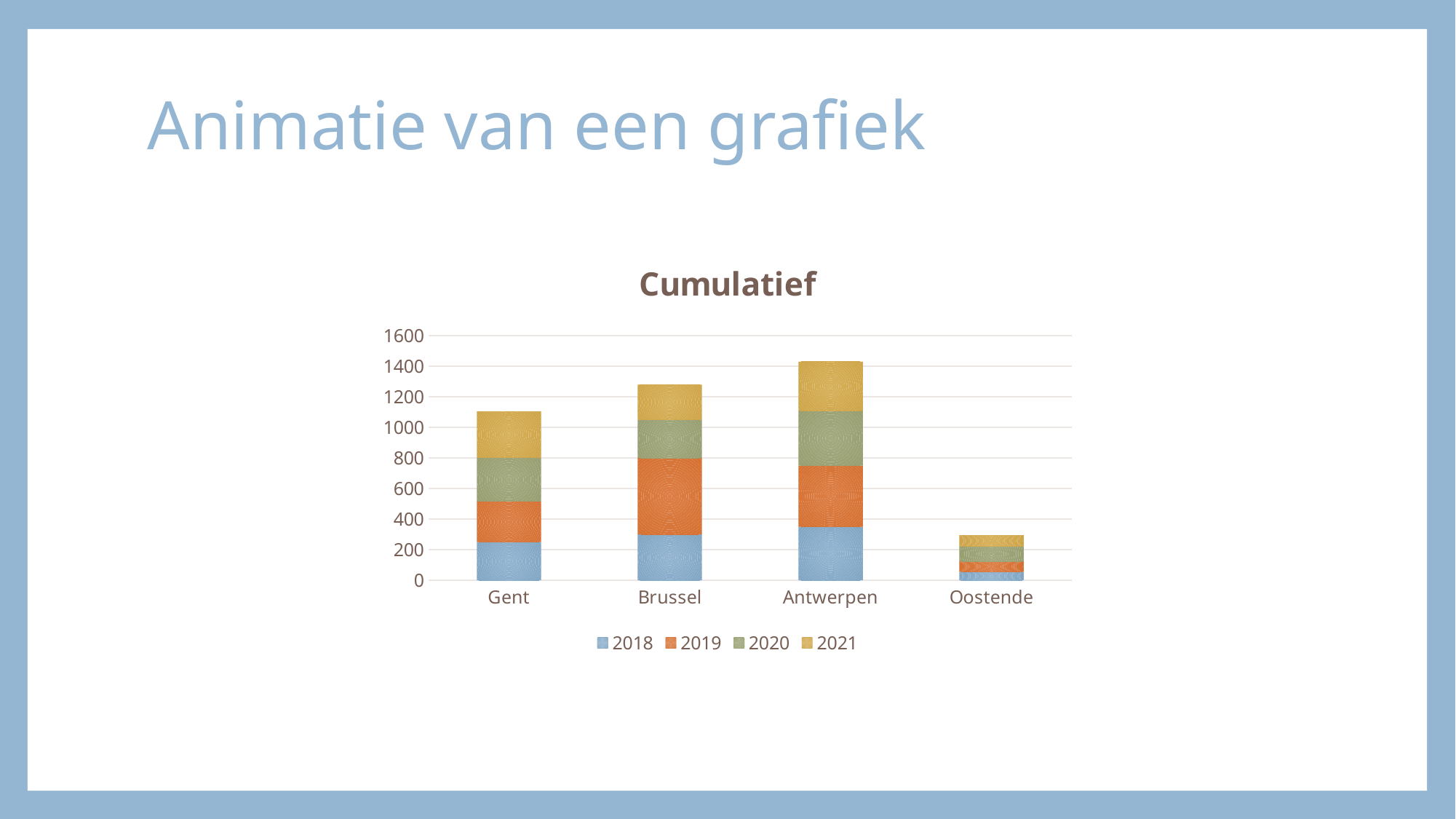
Which has the larger total stacked bar, Brussel or Gent? Brussel Which series is shown in the bottom (blue) segment of each bar? 2018 What kind of chart is shown on the slide? Stacked bar chart Is the total stacked bar for Oostende greater or less than 400? less Is the total stacked bar for Antwerpen greater or less than 1600? less Is the total stacked bar for Brussel greater or less than 1200? greater How many series does the legend list? 4 Which category has the lowest total stacked bar? Oostende How many categories are shown on the x axis? 4 What is the title of the chart? Cumulatief Which category has the highest total stacked bar? Antwerpen